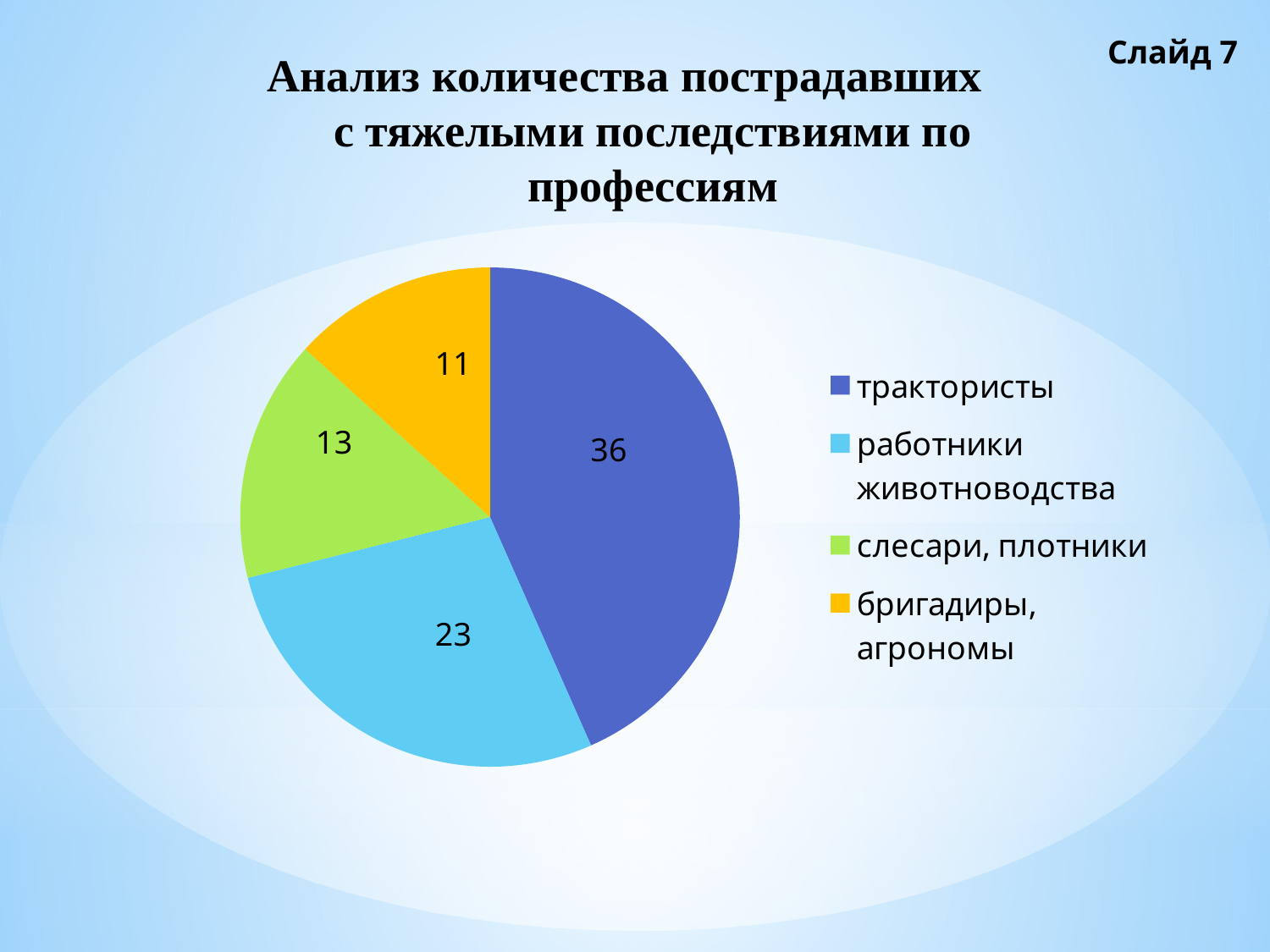
What is the difference between the values for трактористы and работники животноводства? 13 Which is larger, the value for слесари, плотники or the value for бригадиры, агрономы? слесари, плотники How many categories does the pie chart contain? 4 What value is shown for слесари, плотники? 13 Which profession group has the largest slice of the pie? трактористы What value is shown for трактористы in the pie chart? 36 What value is shown for бригадиры, агрономы? 11 Which profession group has the smallest slice of the pie? бригадиры, агрономы What is the total of all values shown in the pie chart? 83 What type of chart is shown on the slide? pie chart What is the title of the chart on the slide? Анализ количества пострадавших с тяжелыми последствиями по профессиям What value is shown for работники животноводства? 23